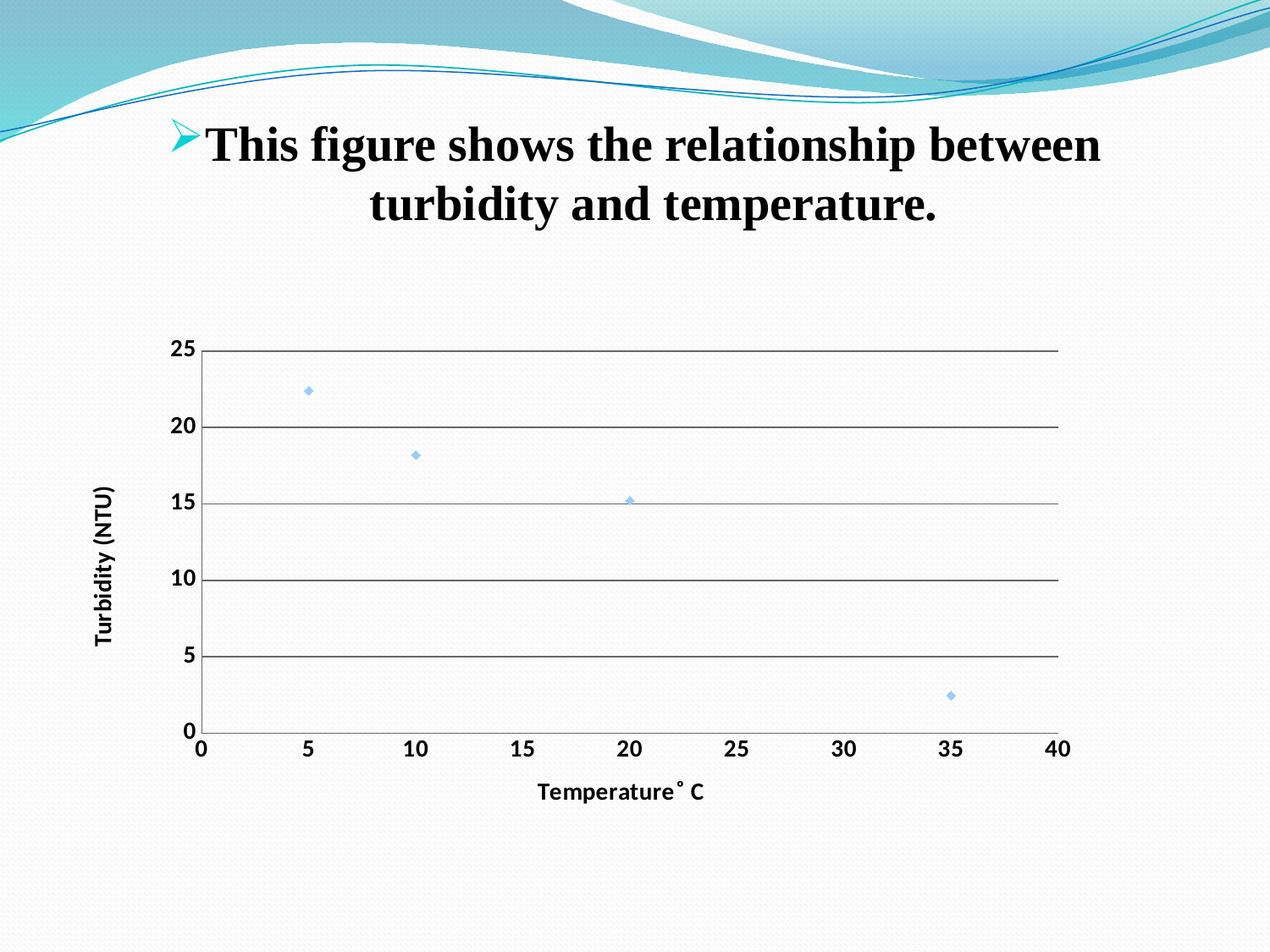
At which temperature is the turbidity highest? 5 Is the turbidity at a temperature of 20 greater or less than 20? less What is the title of the vertical axis? Turbidity (NTU) Is the turbidity at a temperature of 5 greater or less than 20? greater Is the turbidity at a temperature of 35 greater or less than 5? less What kind of chart is shown on the slide? scatter chart As temperature increases along the x axis, does turbidity rise or fall? fall What is the title of the horizontal axis? Temperature˚ C Which has the higher turbidity: the point at temperature 10 or the point at temperature 20? temperature 10 How many data points are plotted on the chart? 4 At which temperature is the turbidity lowest? 35